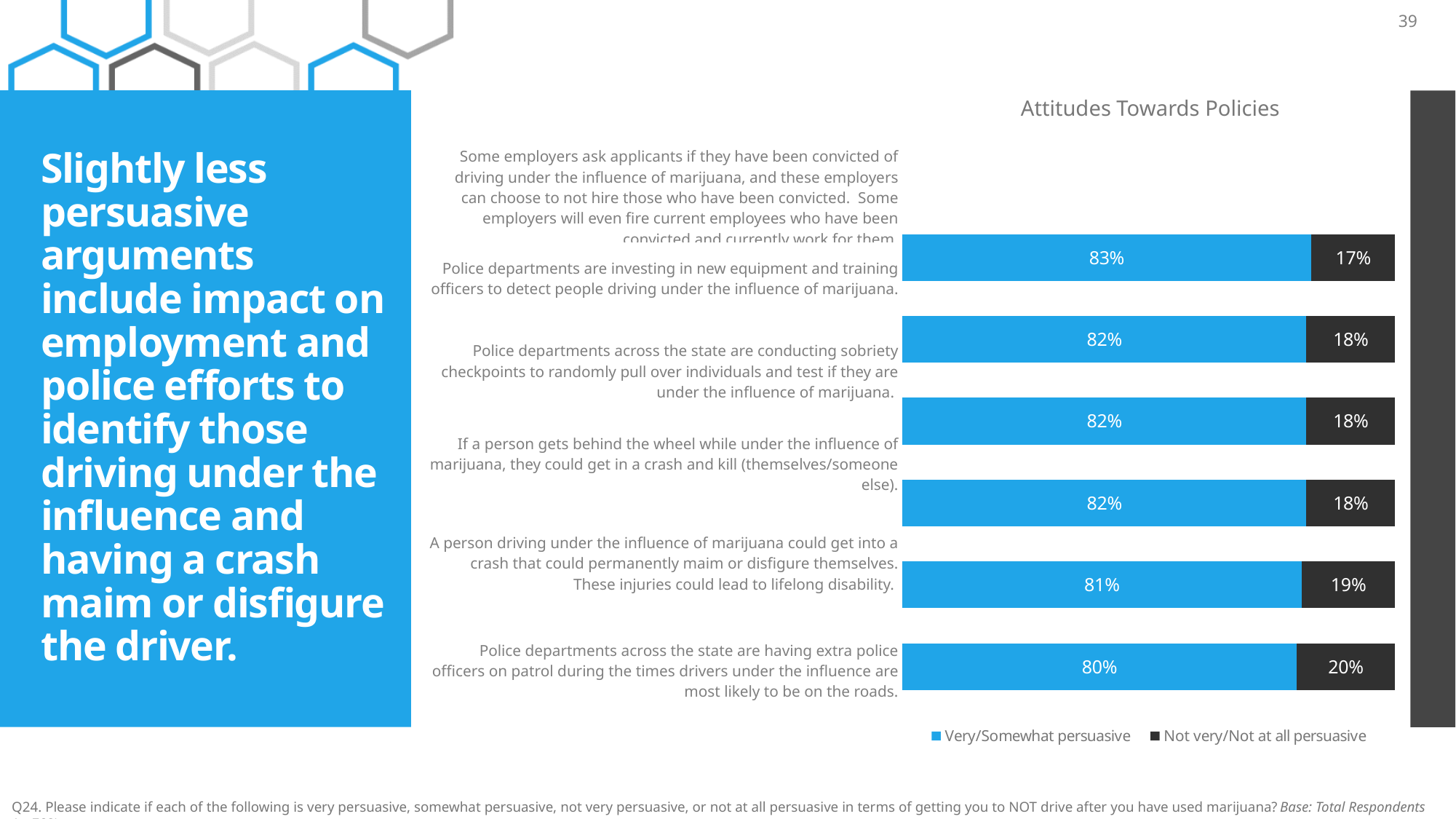
What percentage found the statement about sobriety checkpoints Very/Somewhat persuasive? 82% What percentage found the statement about a crash that could permanently maim or disfigure the driver Very/Somewhat persuasive? 81% What percentage found the statement about police departments having extra police officers on patrol Not very/Not at all persuasive? 20% What percentage found the statement about employers asking applicants about DUI convictions Not very/Not at all persuasive? 17% What is the title of the chart? Attitudes Towards Policies Which statement has the highest Very/Somewhat persuasive percentage? Some employers ask applicants if they have been convicted of driving under the influence of marijuana Which statement has the lowest Very/Somewhat persuasive percentage? Police departments across the state are having extra police officers on patrol What type of chart is shown on the slide? Stacked bar chart How many series does the chart legend list? 2 What percentage found the statement about police departments having extra police officers on patrol Very/Somewhat persuasive? 80% How many policy statements (bars) are shown in the chart? 6 What is the difference between the Very/Somewhat persuasive percentage for the employers statement and the extra police officers on patrol statement? 3 percentage points